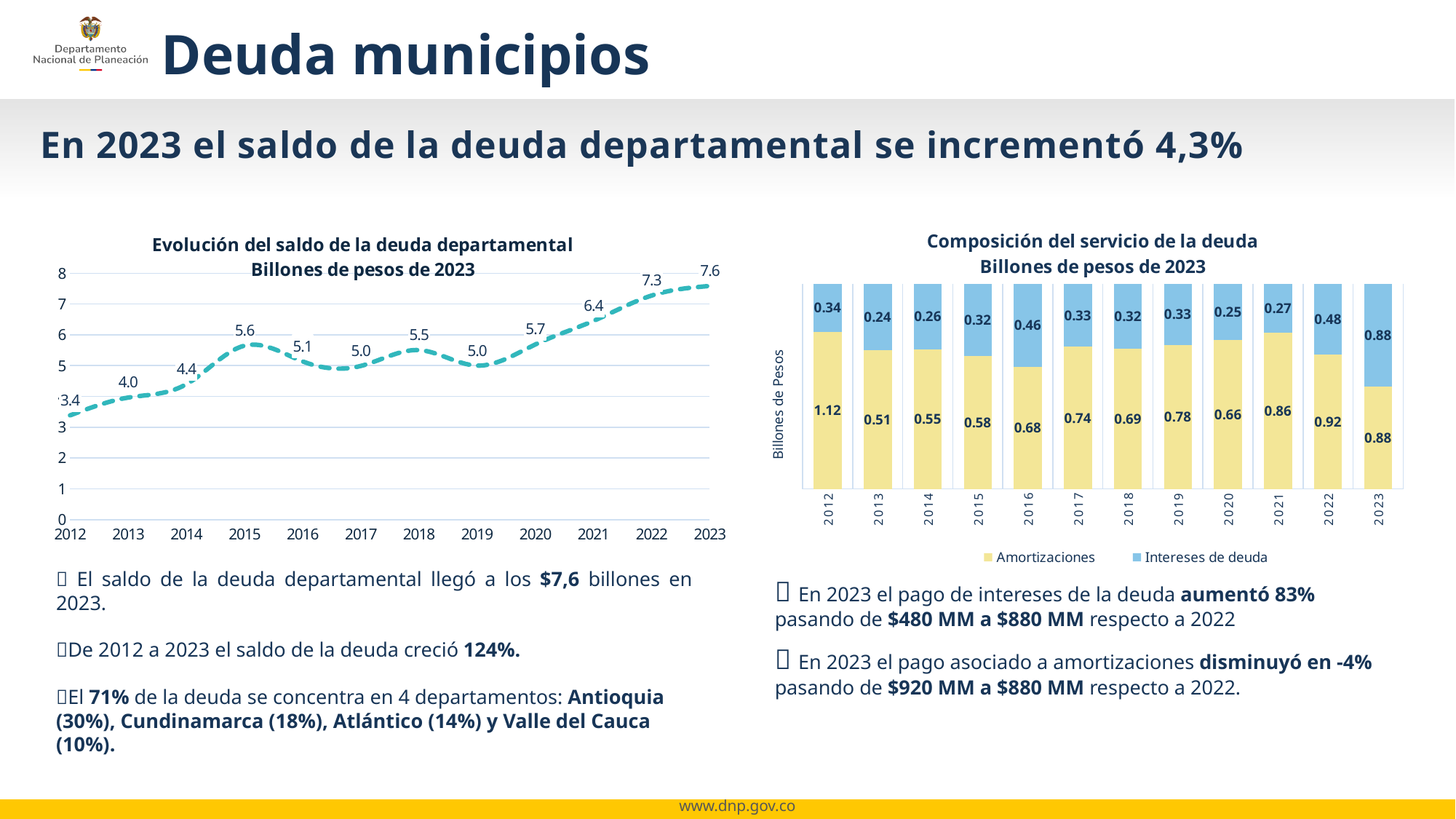
What kind of chart is 'Evolución del saldo de la deuda departamental'? Line chart In the chart 'Composición del servicio de la deuda', which year has the highest Amortizaciones value? 2012 In the chart 'Evolución del saldo de la deuda departamental', how many years are plotted on the x axis? 12 In the chart 'Composición del servicio de la deuda', what is the value of Amortizaciones for 2021? 0.86 In the chart 'Composición del servicio de la deuda', how many series does the legend list? 2 In the chart 'Composición del servicio de la deuda', what is the total of Amortizaciones and Intereses de deuda for 2023? 1.76 In the chart 'Composición del servicio de la deuda', which is larger: Intereses de deuda in 2022 or in 2023? 2023 In the chart 'Evolución del saldo de la deuda departamental', what is the value for 2015? 5.6 In the chart 'Evolución del saldo de la deuda departamental', what is the difference between the values for 2023 and 2012? 4.2 In the chart 'Composición del servicio de la deuda', what is the value of Intereses de deuda for 2016? 0.46 In the chart 'Evolución del saldo de la deuda departamental', what is the value for 2023? 7.6 In the chart 'Evolución del saldo de la deuda departamental', which year has the lowest value? 2012